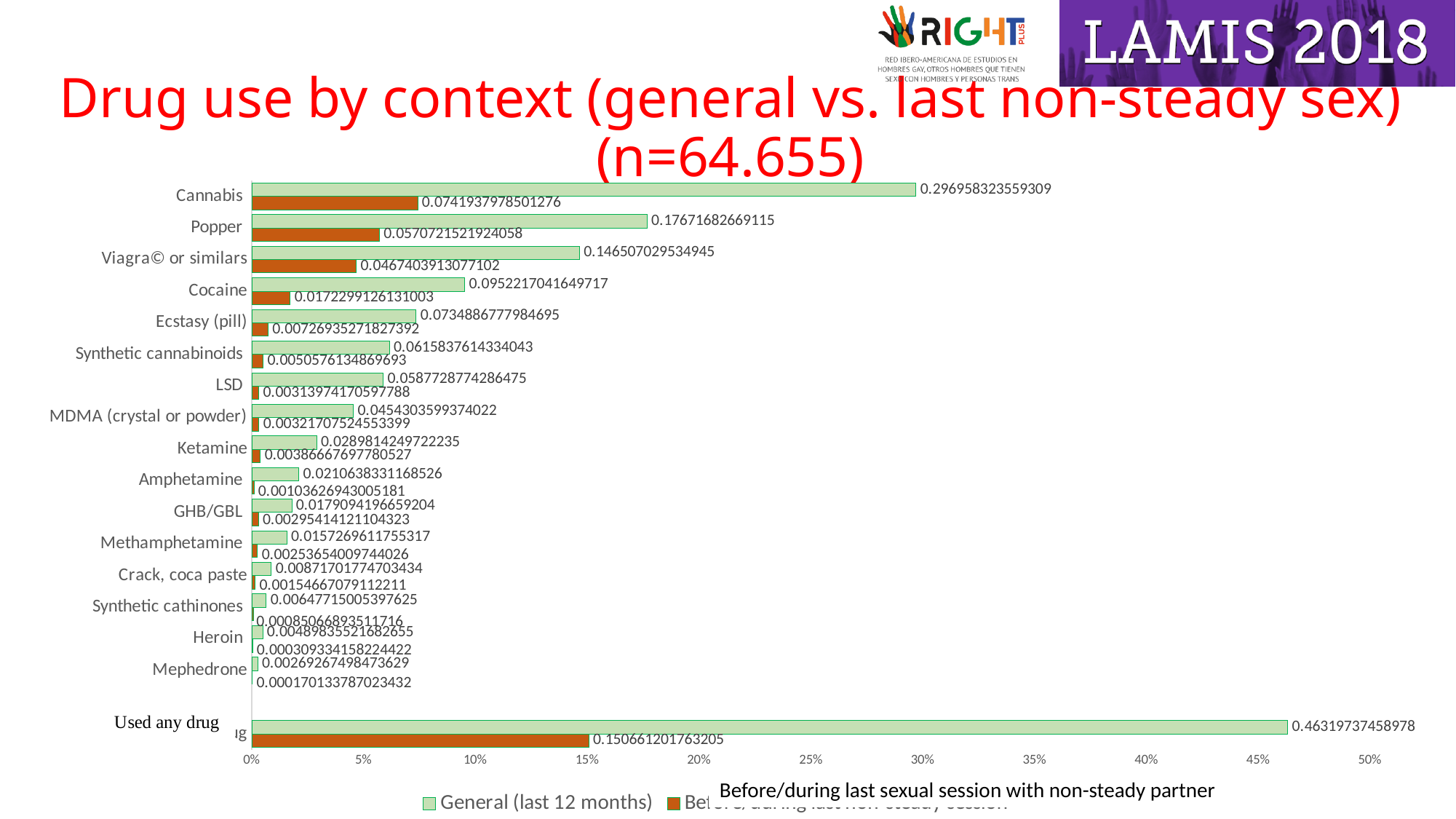
What is the General (last 12 months) value for Cannabis? 0.296958323559309 Which is larger: the General (last 12 months) value for Viagra© or similars or for Cocaine? Viagra© or similars What is the General (last 12 months) value for Popper? 0.17671682669115 How many categories are plotted on the chart? 17 Among the individual drugs (excluding Used any drug), which has the lowest General (last 12 months) value? Mephedrone What is the General (last 12 months) value for Used any drug? 0.46319737458978 What is the value for Cocaine in the Before/during last sexual session with non-steady partner series? 0.0172299126131003 How many series does the legend list? 2 Is the General (last 12 months) value for Cannabis greater or less than 25%? greater Which category has the highest General (last 12 months) value? Used any drug What type of chart is shown on the slide? bar chart What is the first series listed in the legend? General (last 12 months)